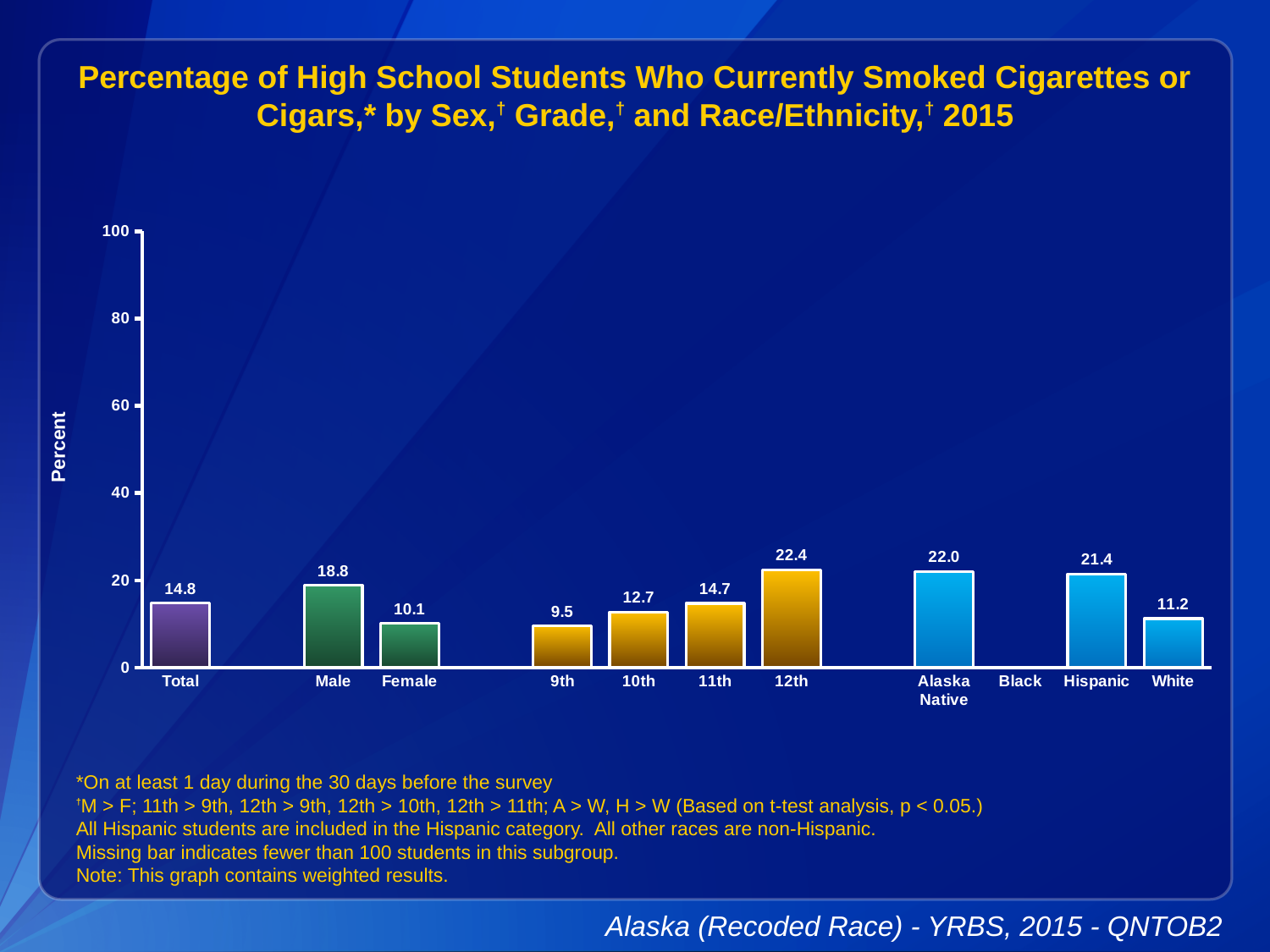
What is the label on the y axis? Percent What is the value for Alaska Native? 22.0 What is the value for Male? 18.8 Do the values rise or fall from 9th grade to 12th grade? rise Which category has the highest value? 12th What is the value for 12th grade? 22.4 Which is larger, the value for Hispanic or the value for White? Hispanic What is the difference between the Male and Female values? 8.7 Which race/ethnicity category has no bar shown? Black Which grade has the lowest value? 9th Is the value for Total greater or less than 20? less What kind of chart is shown? bar chart